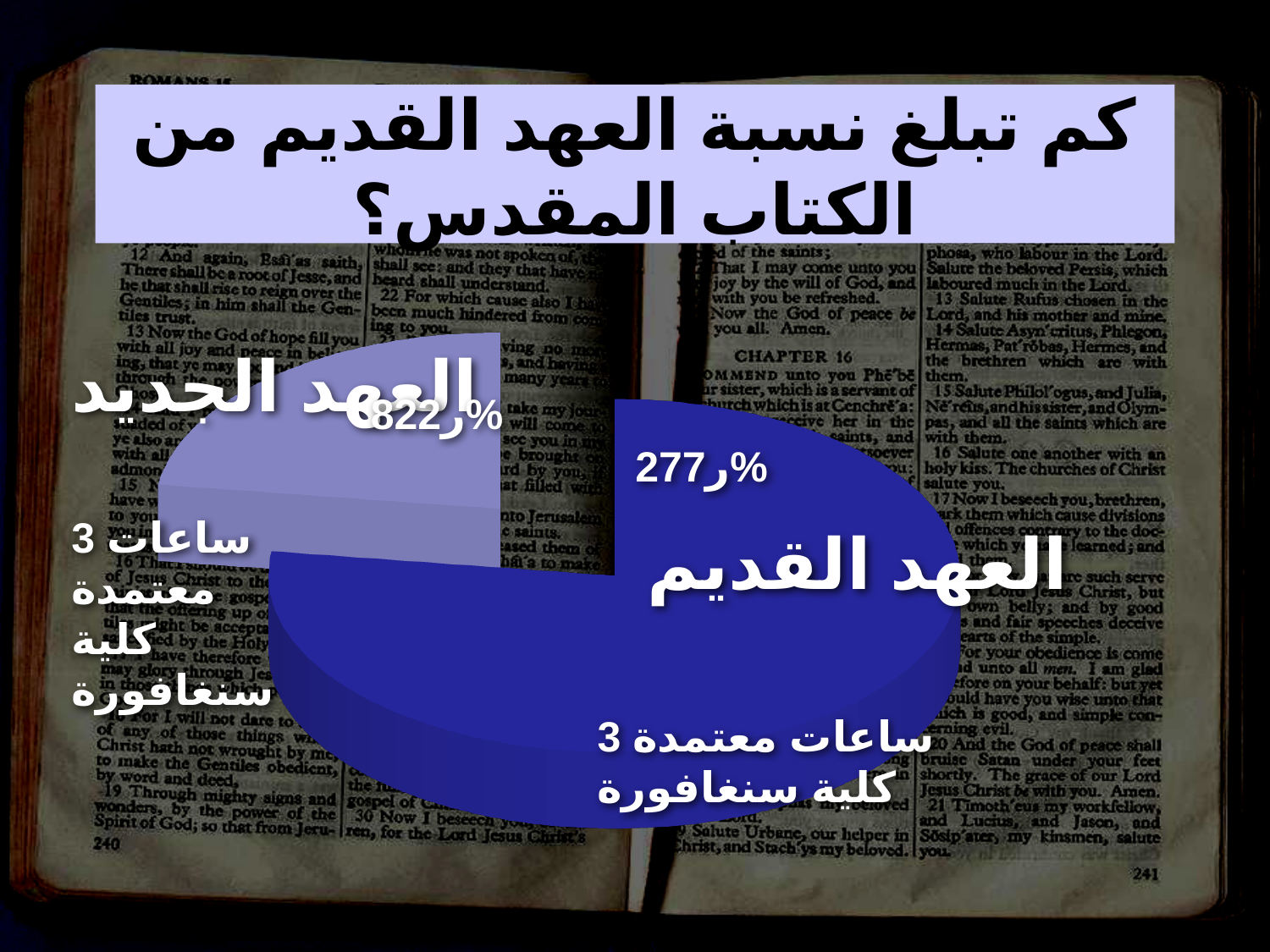
What percentage label is shown on the العهد الجديد slice? 822ر% What percentage label is shown on the العهد القديم slice? 277ر% What kind of chart is shown on the slide? pie chart What is the title of the slide above the chart? كم تبلغ نسبة العهد القديم من الكتاب المقدس؟ Which is larger in the pie chart, العهد القديم or العهد الجديد? العهد القديم What colour is the العهد القديم slice of the pie chart? dark blue Which slice of the pie chart is the smallest? العهد الجديد How many slices does the pie chart have? 2 Does the العهد القديم slice represent more or less than half of the pie? more Which slice of the pie chart is the largest? العهد القديم